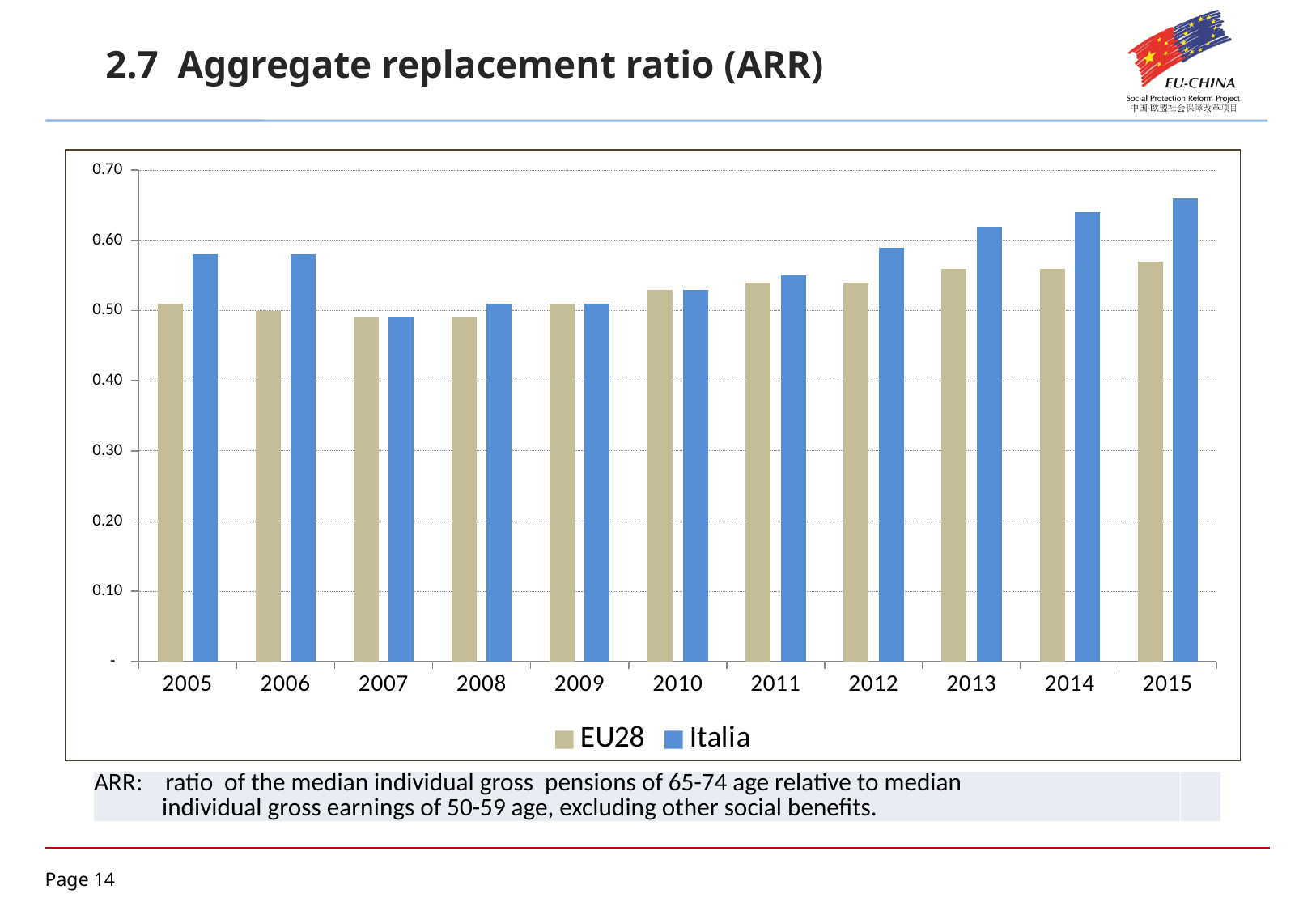
What are the two series named in the legend? EU28 and Italia Is the Italia value for 2005 greater or less than 0.50? greater What kind of chart is shown on the slide? bar chart In which year is the Italia value highest? 2015 In 2012, which is larger, the EU28 value or the Italia value? Italia How many years are shown on the x axis? 11 Is the EU28 value for 2015 greater or less than 0.50? greater How many series does the legend list? 2 Is the Italia value for 2015 greater or less than 0.60? greater Do the Italia values rise or fall from 2009 to 2015? rise In 2015, which is larger, the EU28 value or the Italia value? Italia